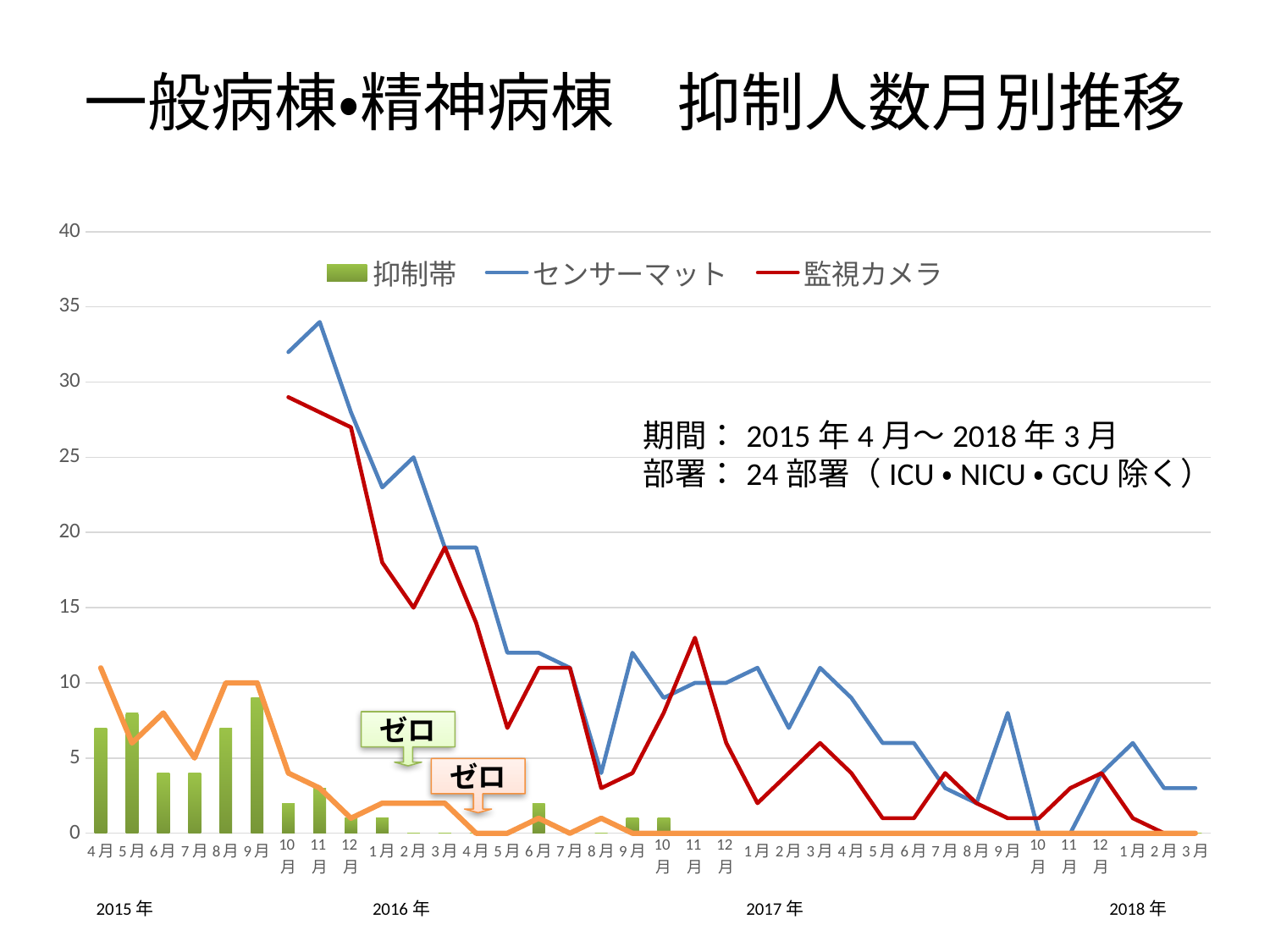
In 2015年10月, which is larger, the センサーマット value or the 監視カメラ value? センサーマット In which month does the センサーマット line reach its highest value? 2015年11月 What colour are the 抑制帯 bars? Green In which month does the 監視カメラ line reach its highest value? 2015年10月 Does the センサーマット line overall rise or fall from 2015年10月 to 2018年3月? Fall How many series does the legend list? 3 How many monthly categories are shown along the x axis? 36 In which month is the 抑制帯 bar the tallest? 2015年9月 Is the 監視カメラ value for 2016年5月 greater or less than 10? less Is the センサーマット value for 2015年10月 greater or less than 30? greater Is the センサーマット value for 2018年3月 greater or less than 5? less What kind of chart is shown on the slide? Combined bar and line chart